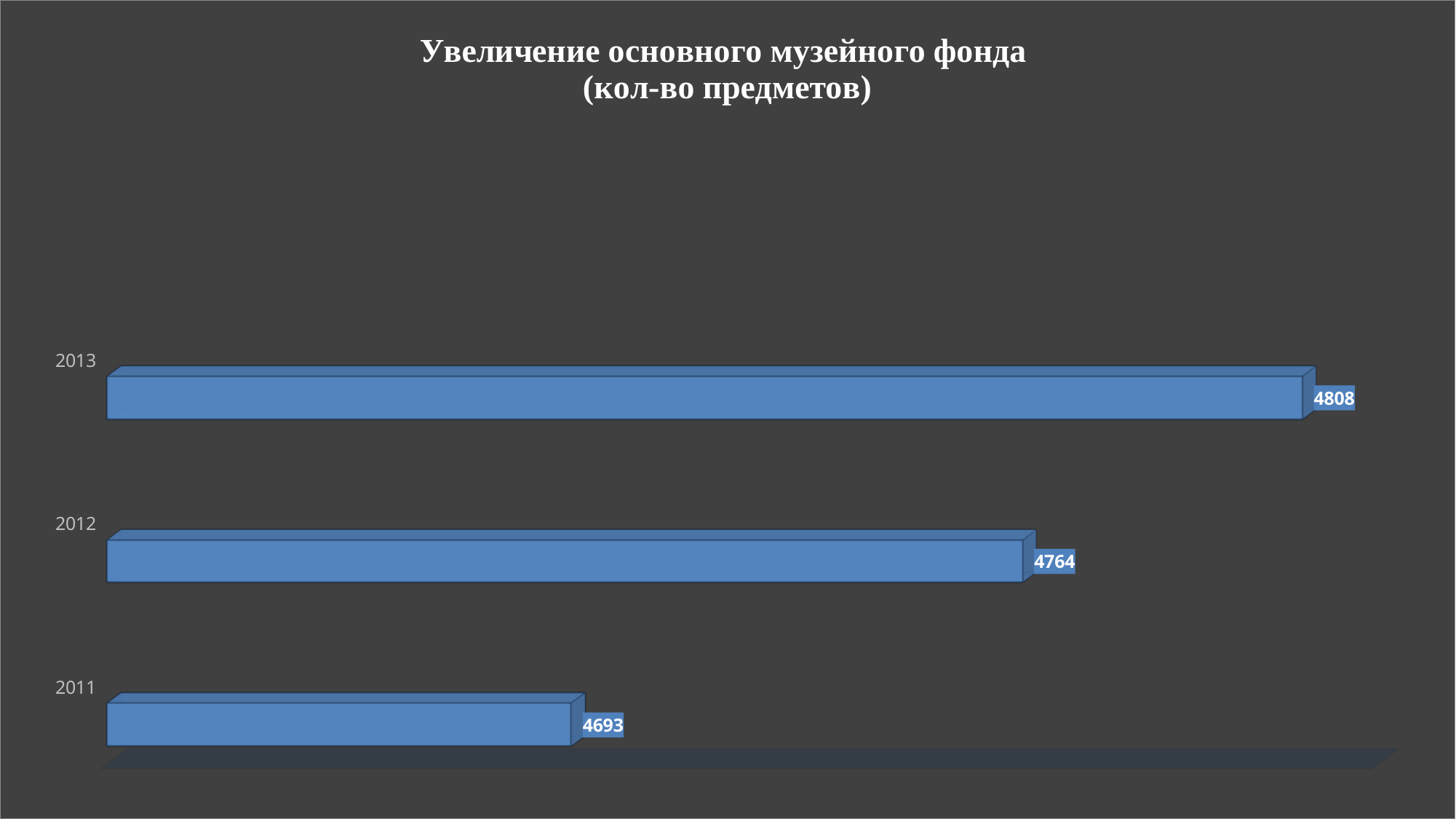
Which is larger, the value for 2012 or the value for 2011? 2012 How many years are shown in the chart? 3 What is the title of the chart? Увеличение основного музейного фонда (кол-во предметов) What kind of chart is shown on the slide? bar chart Which year has the highest value? 2013 What is the difference between the values for 2013 and 2011? 115 Which year has the lowest value? 2011 What is the value for 2011? 4693 What is the value for 2012? 4764 What is the value for 2013? 4808 What is the difference between the values for 2013 and 2012? 44 What is the difference between the values for 2012 and 2011? 71